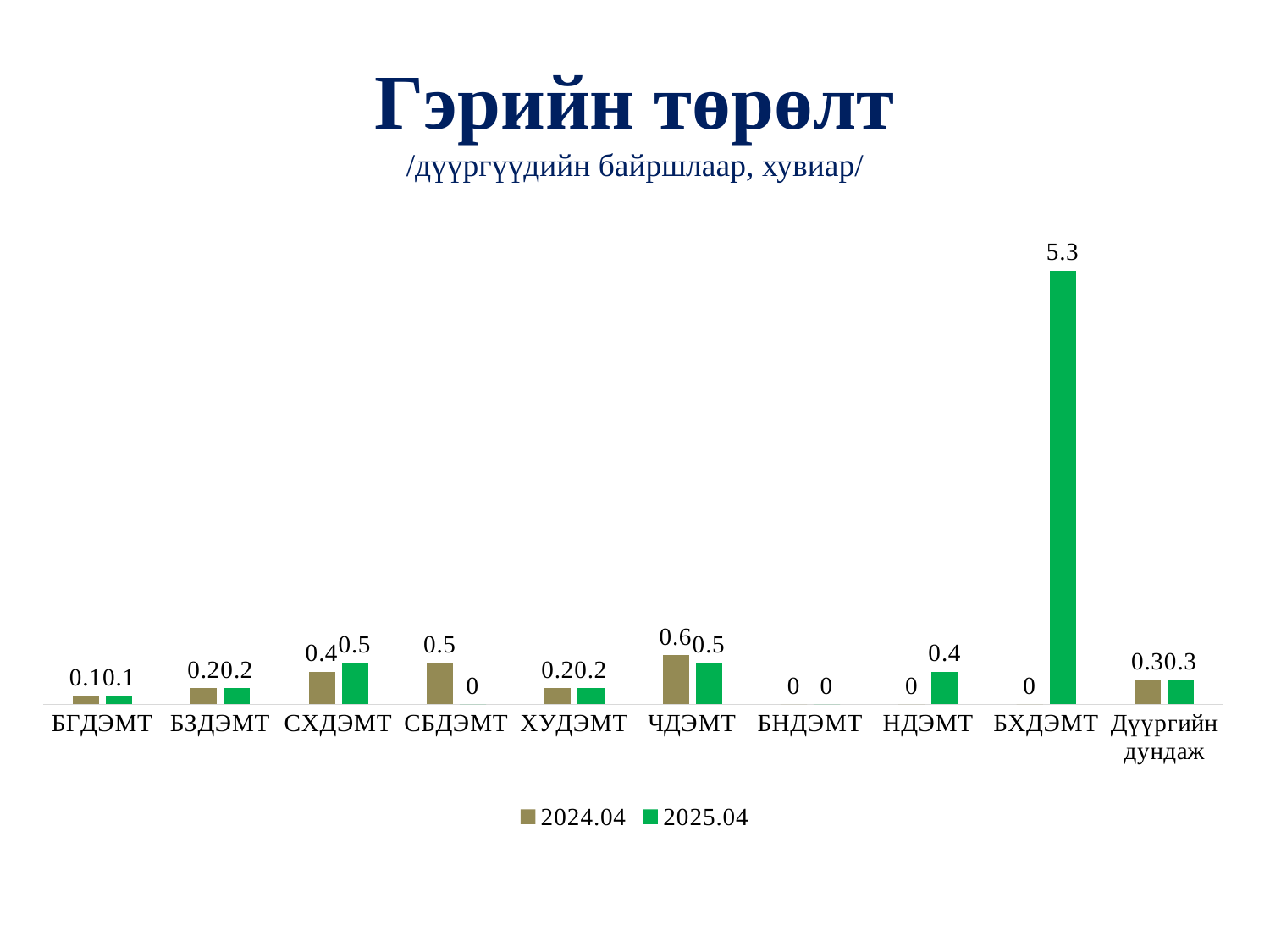
For СХДЭМТ, which is larger: the 2024.04 value or the 2025.04 value? 2025.04 What kind of chart is shown on the slide? Bar chart Which category has the highest 2025.04 value? БХДЭМТ What is the 2024.04 value for ЧДЭМТ? 0.6 How many categories are shown on the x axis? 10 How many series does the legend list? 2 Which category has the highest 2024.04 value? ЧДЭМТ What is the difference between the 2024.04 and 2025.04 values for СБДЭМТ? 0.5 What is the difference between the 2025.04 and 2024.04 values for БХДЭМТ? 5.3 What is the 2025.04 value for БХДЭМТ? 5.3 What is the 2025.04 value for СБДЭМТ? 0 What is the 2024.04 value for НДЭМТ? 0